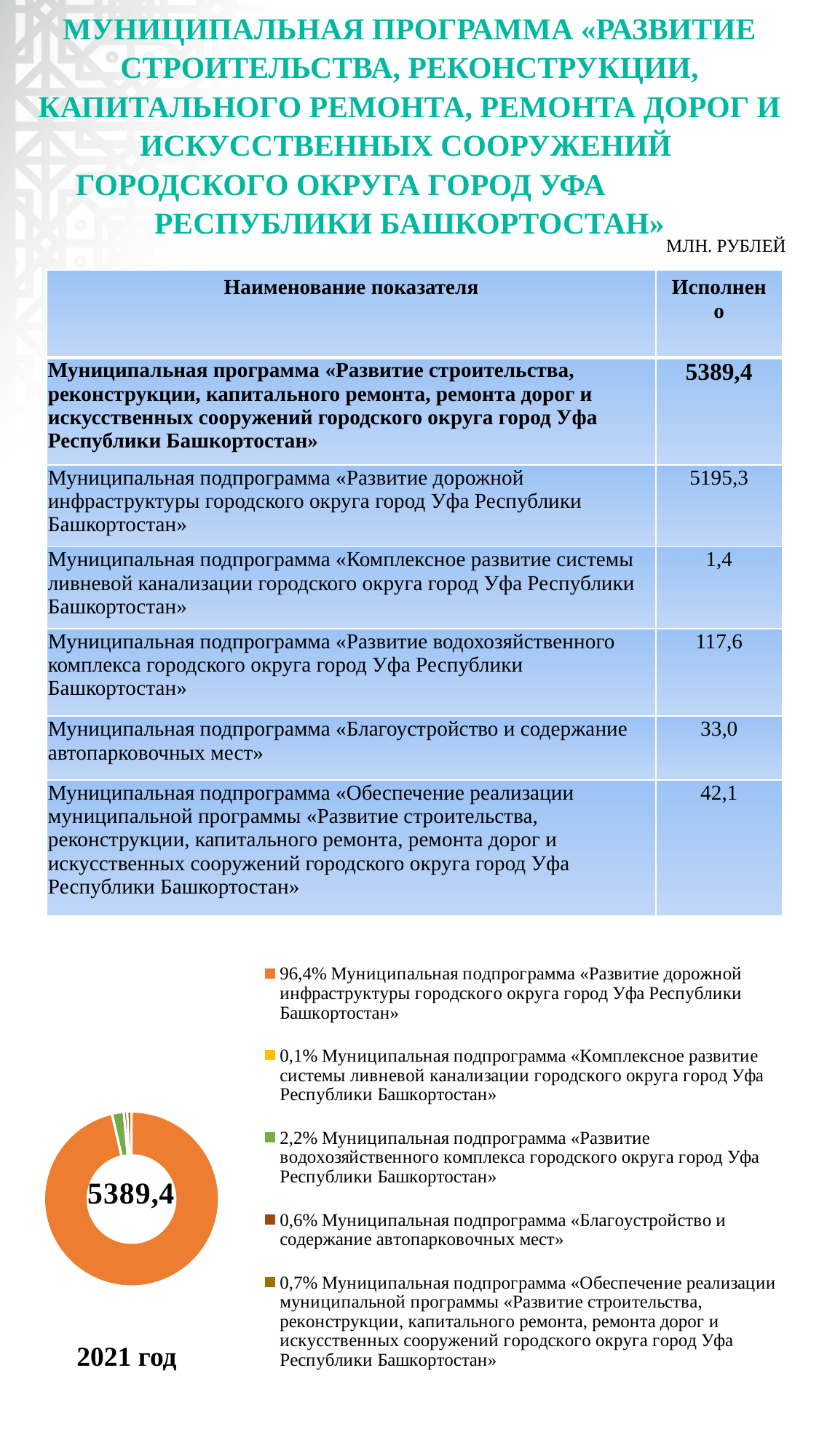
What share of the doughnut chart does the subprogramme «Развитие водохозяйственного комплекса городского округа город Уфа Республики Башкортостан» take? 2,2% How many entries does the legend of the doughnut chart list? 5 Which subprogramme has the largest slice in the doughnut chart? Муниципальная подпрограмма «Развитие дорожной инфраструктуры городского округа город Уфа Республики Башкортостан» What total value is printed in the centre of the doughnut chart? 5389,4 What share of the doughnut chart does the subprogramme «Комплексное развитие системы ливневой канализации городского округа город Уфа Республики Башкортостан» take? 0,1% What colour is the largest slice of the doughnut chart? orange Which year is labelled under the doughnut chart? 2021 год What share of the doughnut chart does the subprogramme «Обеспечение реализации муниципальной программы ...» take? 0,7% Which subprogramme has the smallest slice in the doughnut chart? Муниципальная подпрограмма «Комплексное развитие системы ливневой канализации городского округа город Уфа Республики Башкортостан» What kind of chart is shown at the bottom of the slide? doughnut (pie) chart